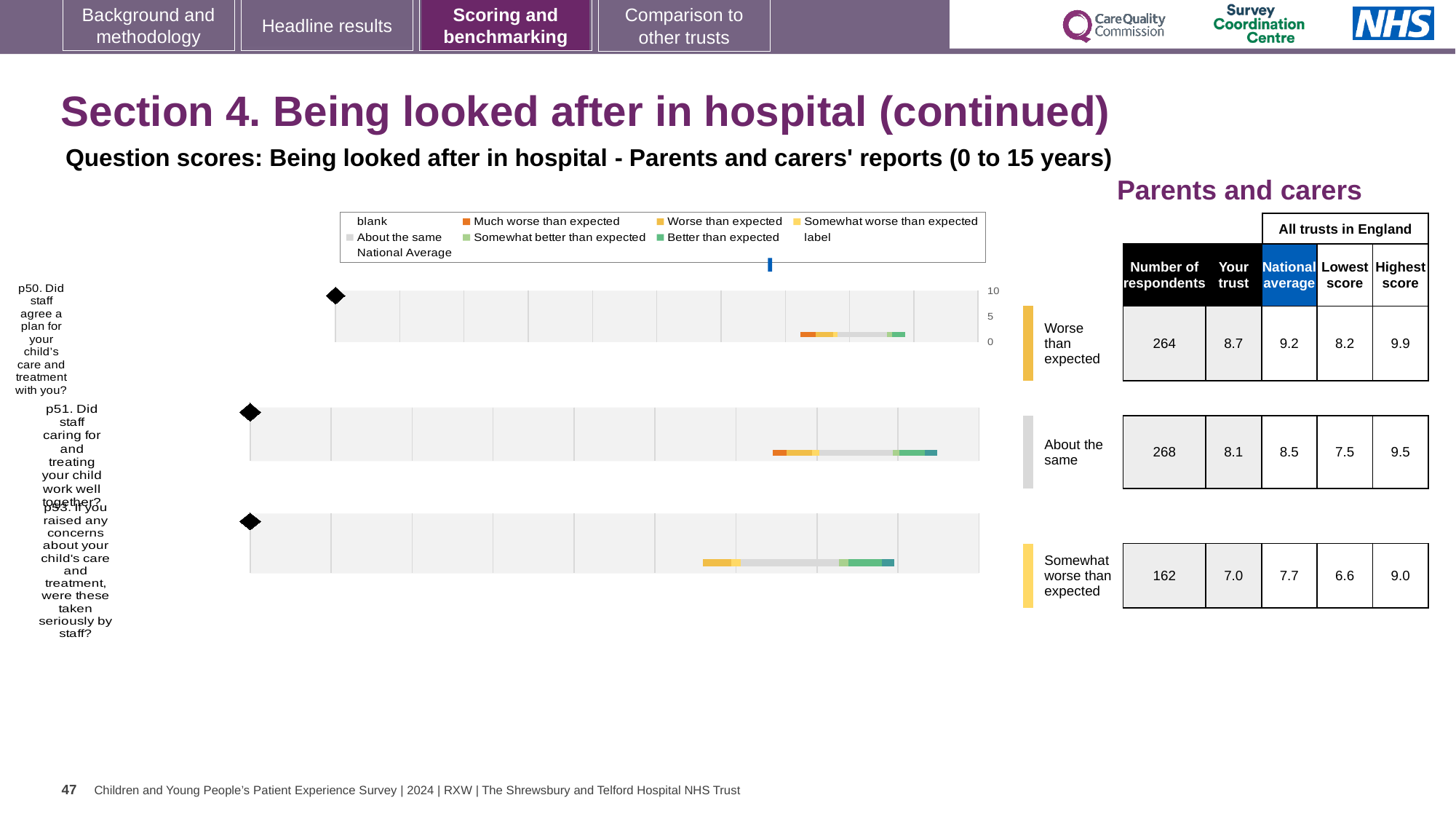
How many questions (charts) are shown on this slide? 3 For p50, what is the national average score? 9.2 What is the difference between the national average and the 'Your trust' score for p51? 0.4 Which of the three questions has the lowest 'Your trust' score? p53 For p51 (Did staff caring for and treating your child work well together?), how many respondents were there? 268 What kind of chart is used to show the benchmark bands for each question on this slide? bar chart What benchmark category label is shown next to the p50 chart? Worse than expected Which of the three questions has the highest number of respondents? p51 For p50 (Did staff agree a plan for your child's care and treatment with you?), what is the 'Your trust' score? 8.7 For p53 (If you raised any concerns about your child's care and treatment, were these taken seriously by staff?), what is the lowest score among all trusts in England? 6.6 Is the 'Your trust' score for p50 higher or lower than the national average? lower For p53, what is the highest score among all trusts in England? 9.0